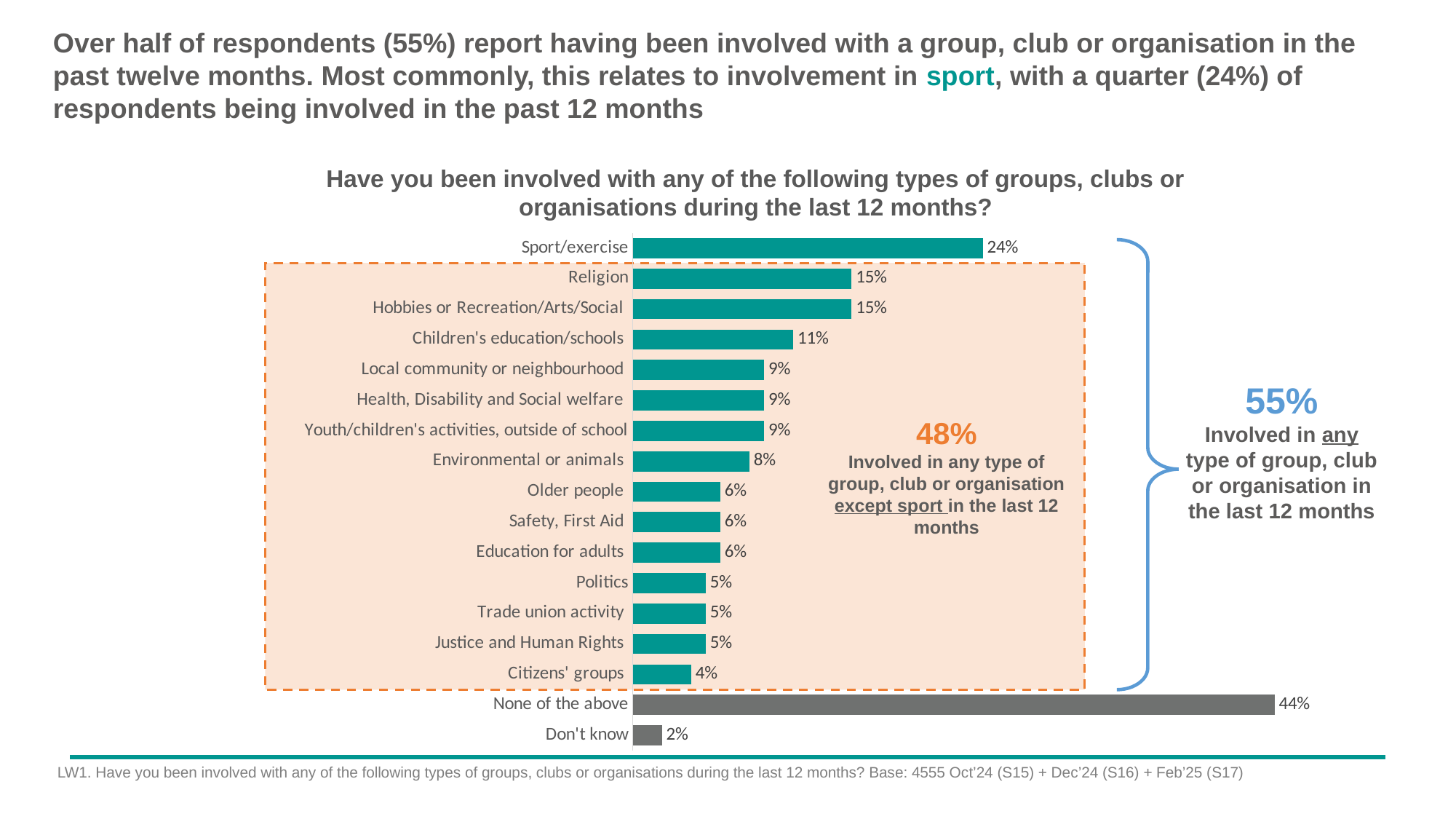
Which category has the lowest value on the chart? Don't know What percentage of respondents were involved in Sport/exercise groups? 24% How many categories are shown on the chart? 17 What percentage of respondents selected None of the above? 44% Which type of group, club or organisation has the highest percentage of involvement? Sport/exercise What is the value for Hobbies or Recreation/Arts/Social? 15% What is the value for Citizens' groups? 4% Which is larger, the value for Environmental or animals or the value for Older people? Environmental or animals What is the difference between the values for Sport/exercise and Religion? 9 percentage points What is the value shown for Children's education/schools? 11% What percentage is shown in the orange dashed box for involvement in any type of group, club or organisation except sport? 48% What kind of chart is shown on the slide? Bar chart